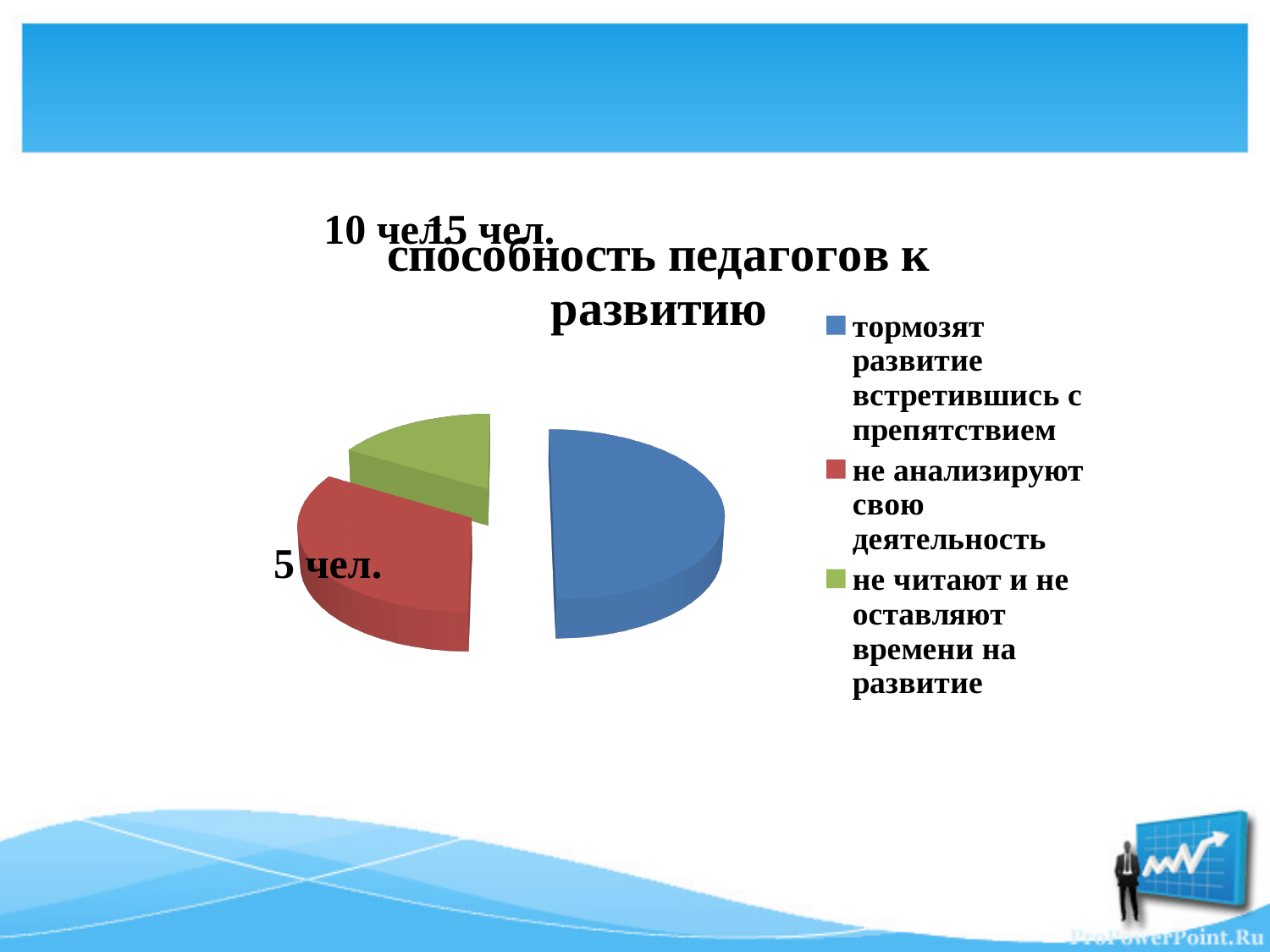
What is the title of the chart? способность педагогов к развитию Which slice is larger: 'не анализируют свою деятельность' or 'не читают и не оставляют времени на развитие'? не анализируют свою деятельность How many slices does the pie chart have? 3 Which slice is larger: 'тормозят развитие встретившись с препятствием' or 'не анализируют свою деятельность'? тормозят развитие встретившись с препятствием How many entries does the legend list? 3 What kind of chart is shown on the slide? pie chart Which category has the smallest slice of the pie? не читают и не оставляют времени на развитие Which slice is larger: 'тормозят развитие встретившись с препятствием' or 'не читают и не оставляют времени на развитие'? тормозят развитие встретившись с препятствием What colour is the slice for 'не анализируют свою деятельность'? red Which category has the largest slice of the pie? тормозят развитие встретившись с препятствием